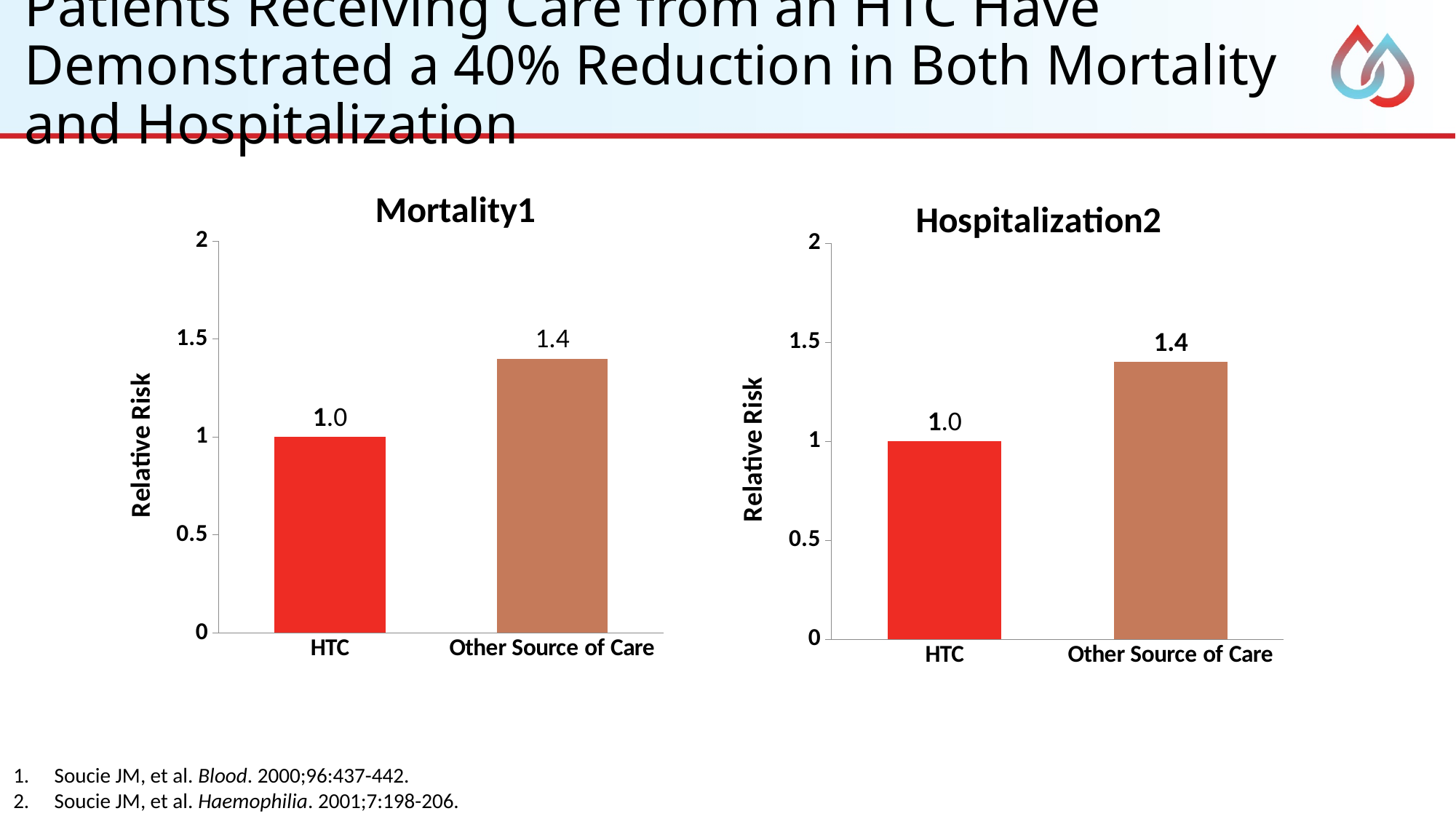
In the Hospitalization2 chart, which category has the lower relative risk? HTC In the Hospitalization2 chart, what colour is the HTC bar? Red In the Mortality1 chart, what is the relative risk for Other Source of Care? 1.4 In the Mortality1 chart, what is the relative risk for HTC? 1.0 In the Hospitalization2 chart, what is the relative risk for HTC? 1.0 What is the y-axis label of the Mortality1 chart? Relative Risk In the Hospitalization2 chart, what is the relative risk for Other Source of Care? 1.4 In the Mortality1 chart, which category has the higher relative risk? Other Source of Care In the Hospitalization2 chart, is the relative risk for Other Source of Care greater or less than 1.5? less What type of chart is the Hospitalization2 chart? Bar chart How many categories are shown in the Mortality1 chart? 2 In the Mortality1 chart, what is the difference in relative risk between Other Source of Care and HTC? 0.4